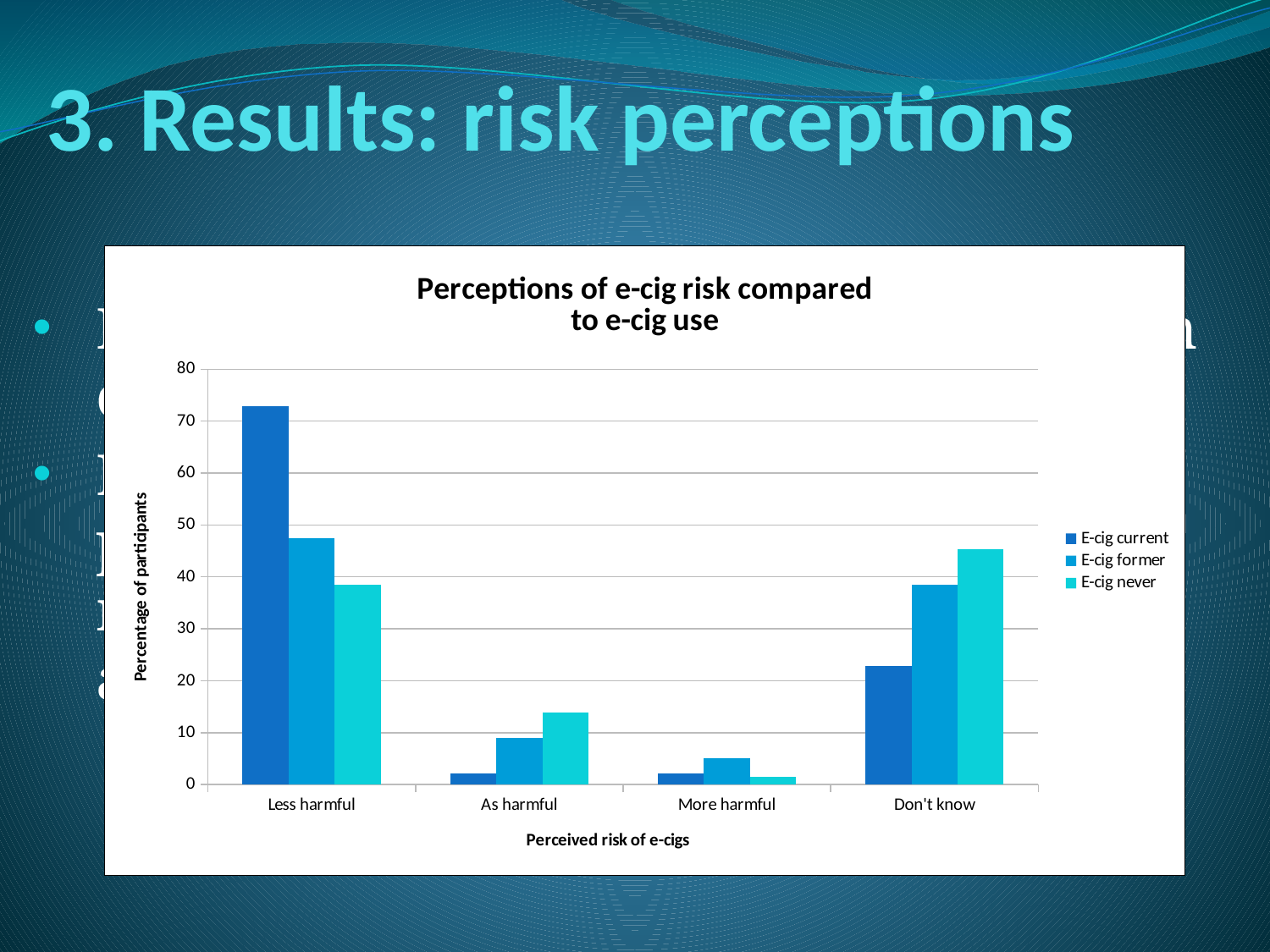
How many categories are shown on the x axis? 4 Is the value for E-cig never in the Less harmful category greater or less than 40? less Which category has the highest value for the E-cig never series? Don't know In the Less harmful category, which series has the larger value: E-cig current or E-cig never? E-cig current How many series does the legend list? 3 What is the label of the y axis? Percentage of participants Is the value for E-cig current in the Less harmful category greater or less than 70? greater What is the title of the chart? Perceptions of e-cig risk compared to e-cig use Which category has the highest value for the E-cig current series? Less harmful Is the value for E-cig former in the Don't know category greater or less than 30? greater In the Don't know category, which series has the larger value: E-cig current or E-cig never? E-cig never What kind of chart is shown on the slide? Bar chart